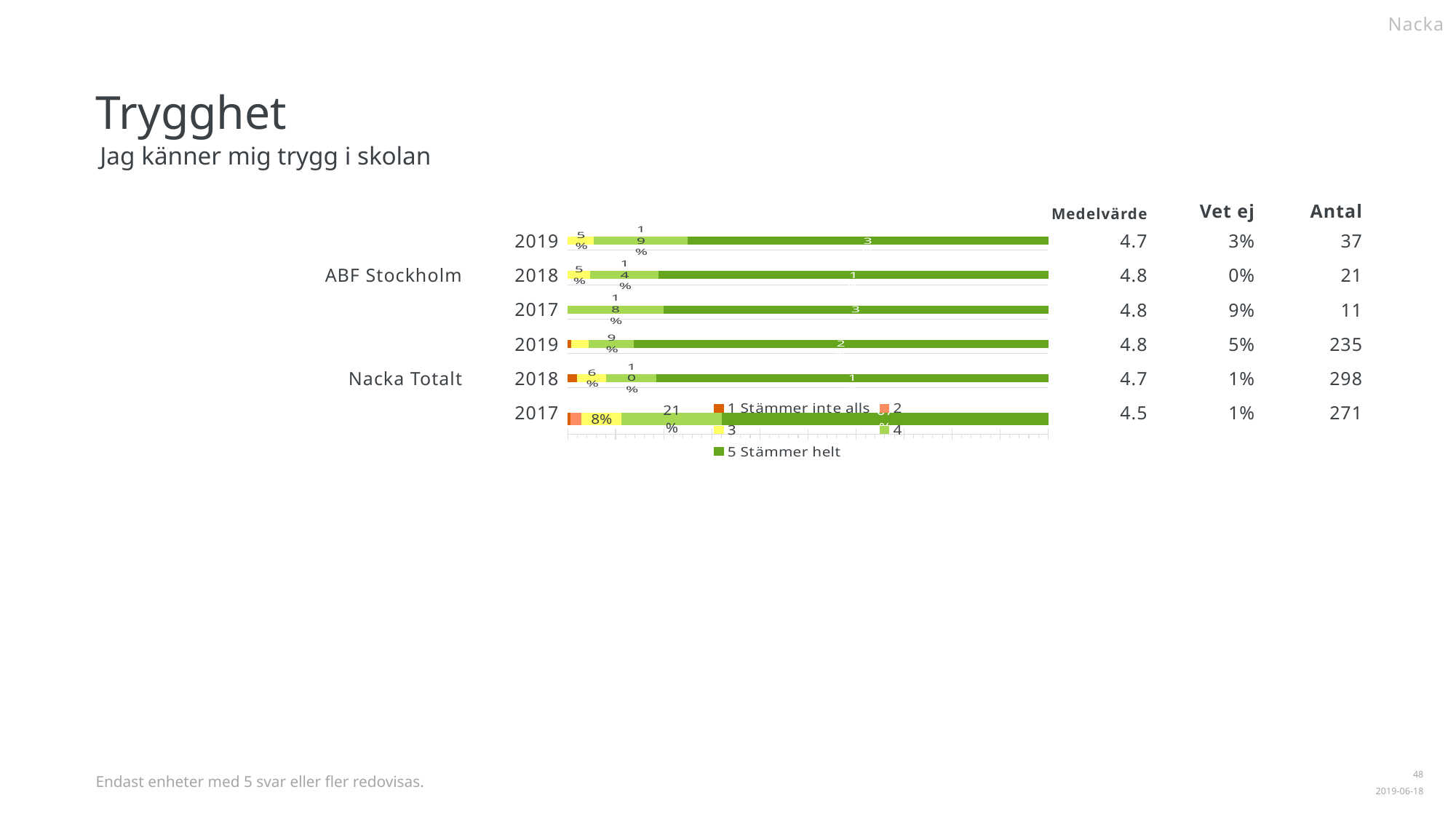
How many series does the chart legend list? 5 Which has the larger '4' segment: ABF Stockholm 2019 or ABF Stockholm 2018? ABF Stockholm 2019 What is the first entry in the chart legend? 1 Stämmer inte alls What is the value of the '4' segment for ABF Stockholm in 2018? 14% What is the value of the '4' segment for ABF Stockholm in 2017? 18% What is the value of the '4' segment for ABF Stockholm in 2019? 19% How many bars (year rows) are plotted in the chart? 6 What is the value of the '3' segment for Nacka Totalt in 2017? 8% What is the value of the '4' segment for Nacka Totalt in 2017? 21% What is the value of the '3' segment for ABF Stockholm in 2019? 5% What kind of chart is shown on the slide? Stacked horizontal bar chart What is the value of the '4' segment for Nacka Totalt in 2019? 9%